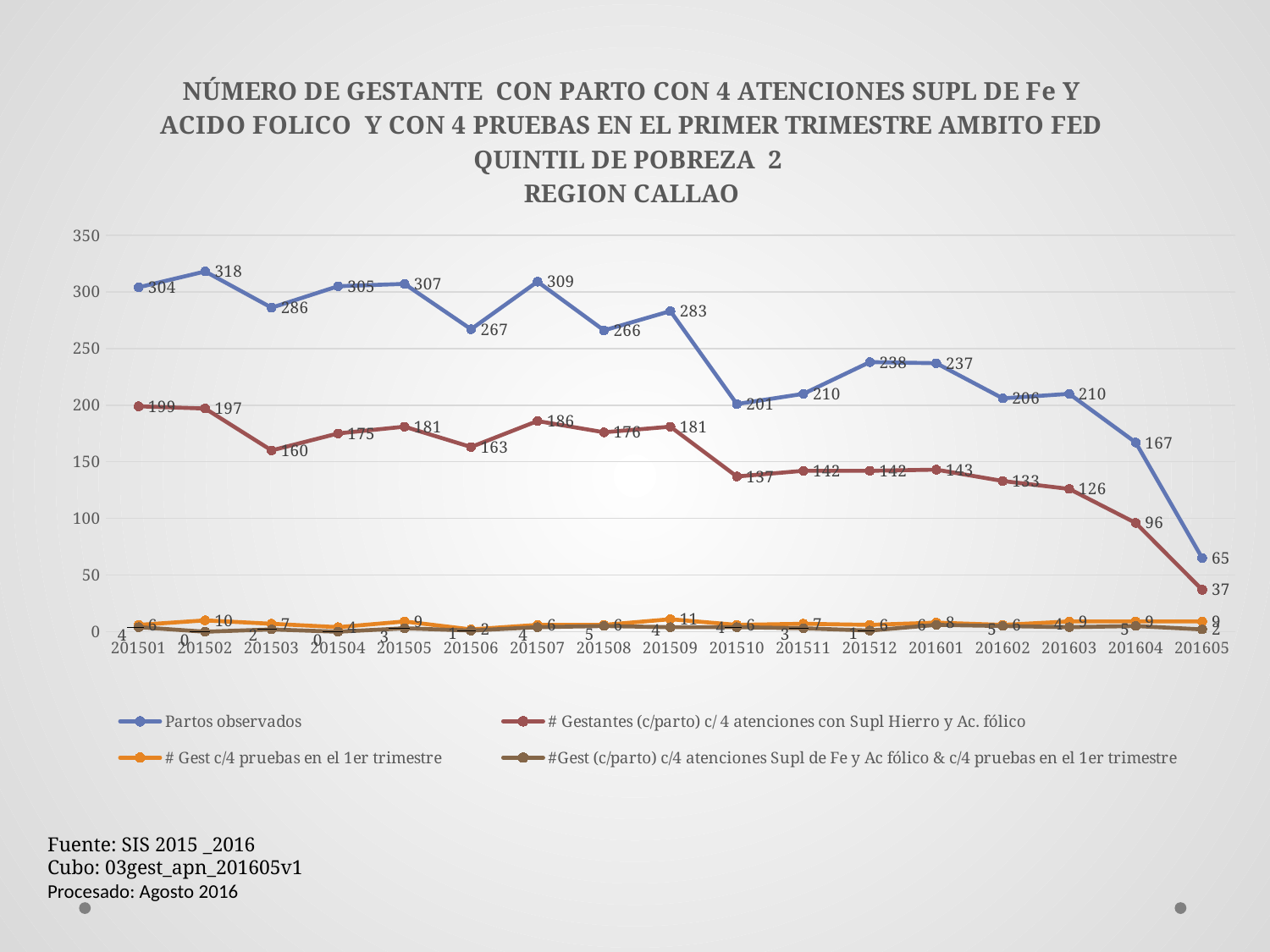
What type of chart is shown on the slide? line chart What is the value of Partos observados for 201502? 318 How many series does the legend list? 4 What is the value of # Gestantes (c/parto) c/ 4 atenciones con Supl Hierro y Ac. fólico for 201507? 186 In which period is # Gestantes (c/parto) c/ 4 atenciones con Supl Hierro y Ac. fólico lowest? 201605 What is the difference between Partos observados and # Gestantes (c/parto) c/ 4 atenciones con Supl Hierro y Ac. fólico in 201501? 105 What is the value of Partos observados for 201605? 65 Overall, do the Partos observados values rise or fall from 201501 to 201605? fall How many periods are shown on the x axis? 17 Which region does the chart title refer to? REGION CALLAO Which is larger: Partos observados in 201510 or Partos observados in 201511? 201511 In which period is Partos observados highest? 201502